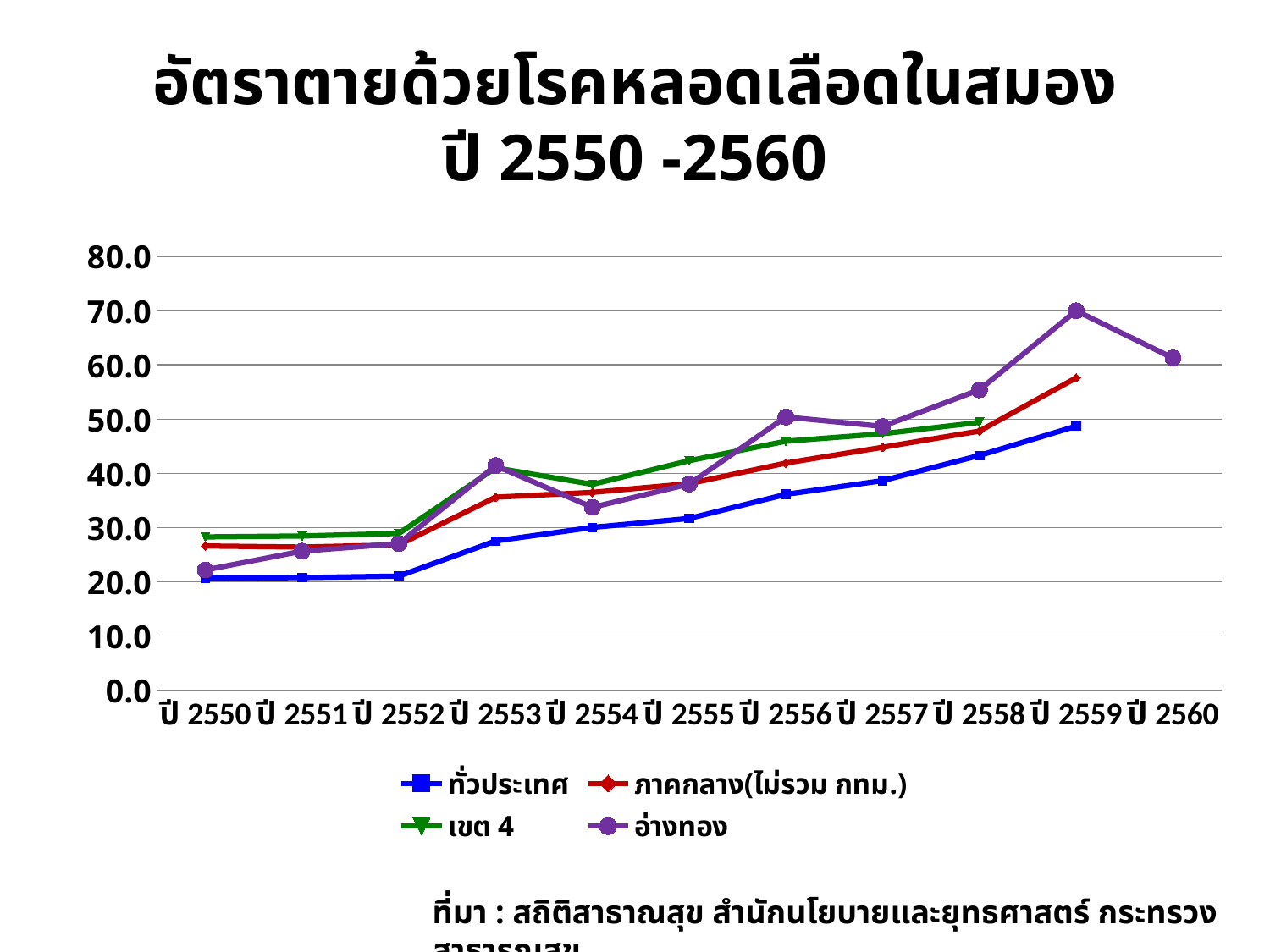
Does the value for ทั่วประเทศ generally rise or fall from ปี 2550 to ปี 2560? rise What colour is the line for เขต 4? green In which year is the value for อ่างทอง highest? ปี 2559 In ปี 2559, which is larger: the value for อ่างทอง or the value for ทั่วประเทศ? อ่างทอง Is the value for อ่างทอง in ปี 2554 greater or less than 40? less How many series does the legend list? 4 How many years are shown along the x axis? 11 Is the value for ทั่วประเทศ in ปี 2550 greater or less than 30? less What kind of chart is shown on the slide? line chart Is the value for อ่างทอง in ปี 2559 greater or less than 60? greater